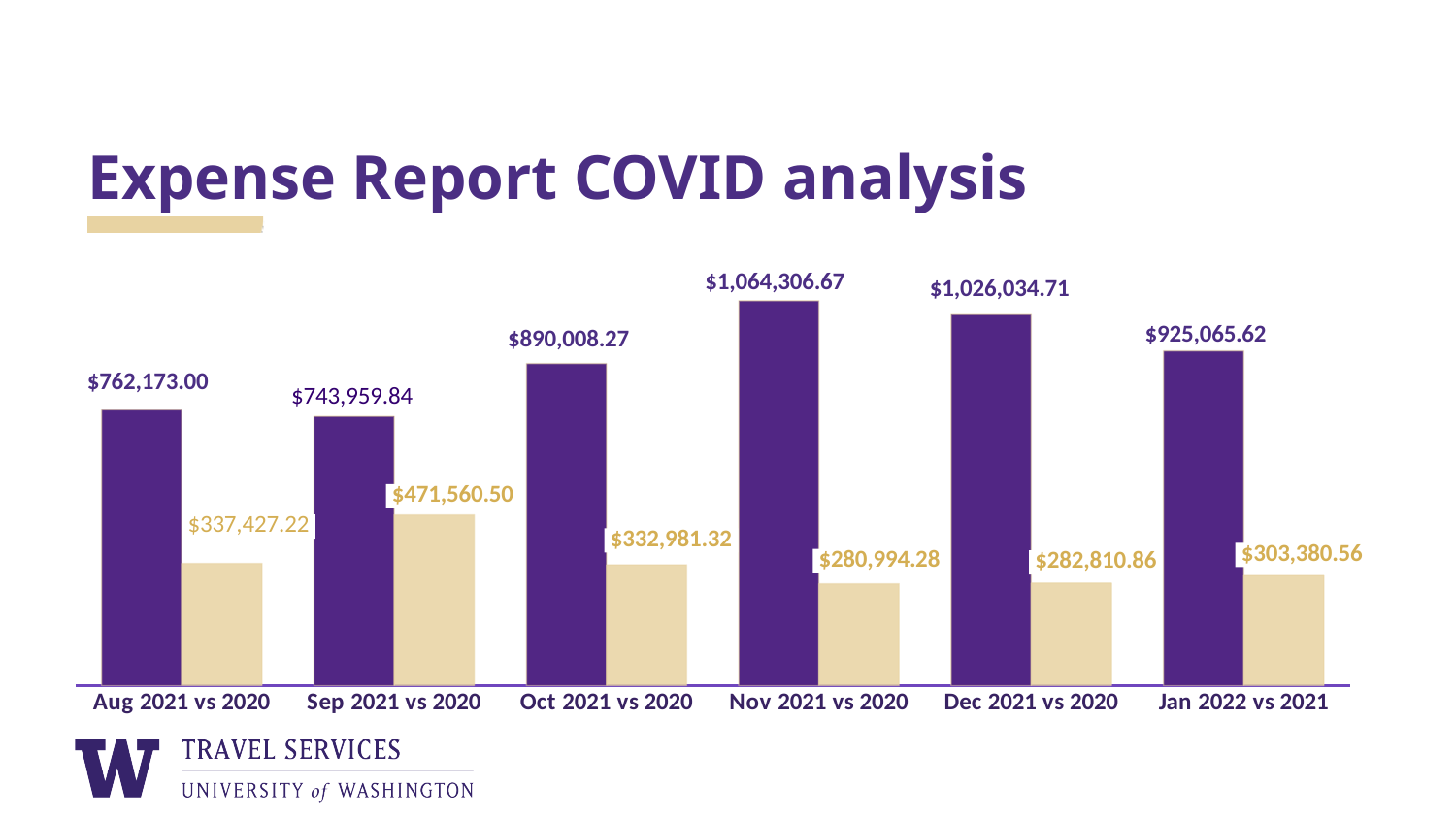
What is the value of the tan bar for Sep 2021 vs 2020? $471,560.50 Do the purple bars rise or fall from Sep 2021 vs 2020 to Nov 2021 vs 2020? Rise What is the value of the tan bar for Jan 2022 vs 2021? $303,380.56 What is the difference between the purple and tan bars for Aug 2021 vs 2020? $424,745.78 What is the value of the purple bar for Oct 2021 vs 2020? $890,008.27 Which category has the highest purple bar? Nov 2021 vs 2020 What is the difference between the purple and tan bars for Nov 2021 vs 2020? $783,312.39 Which is larger, the purple bar for Dec 2021 vs 2020 or the purple bar for Jan 2022 vs 2021? Dec 2021 vs 2020 How many categories are shown on the x axis? 6 What kind of chart is shown on the slide? Bar chart Which category has the lowest purple bar? Sep 2021 vs 2020 Which category has the highest tan bar? Sep 2021 vs 2020